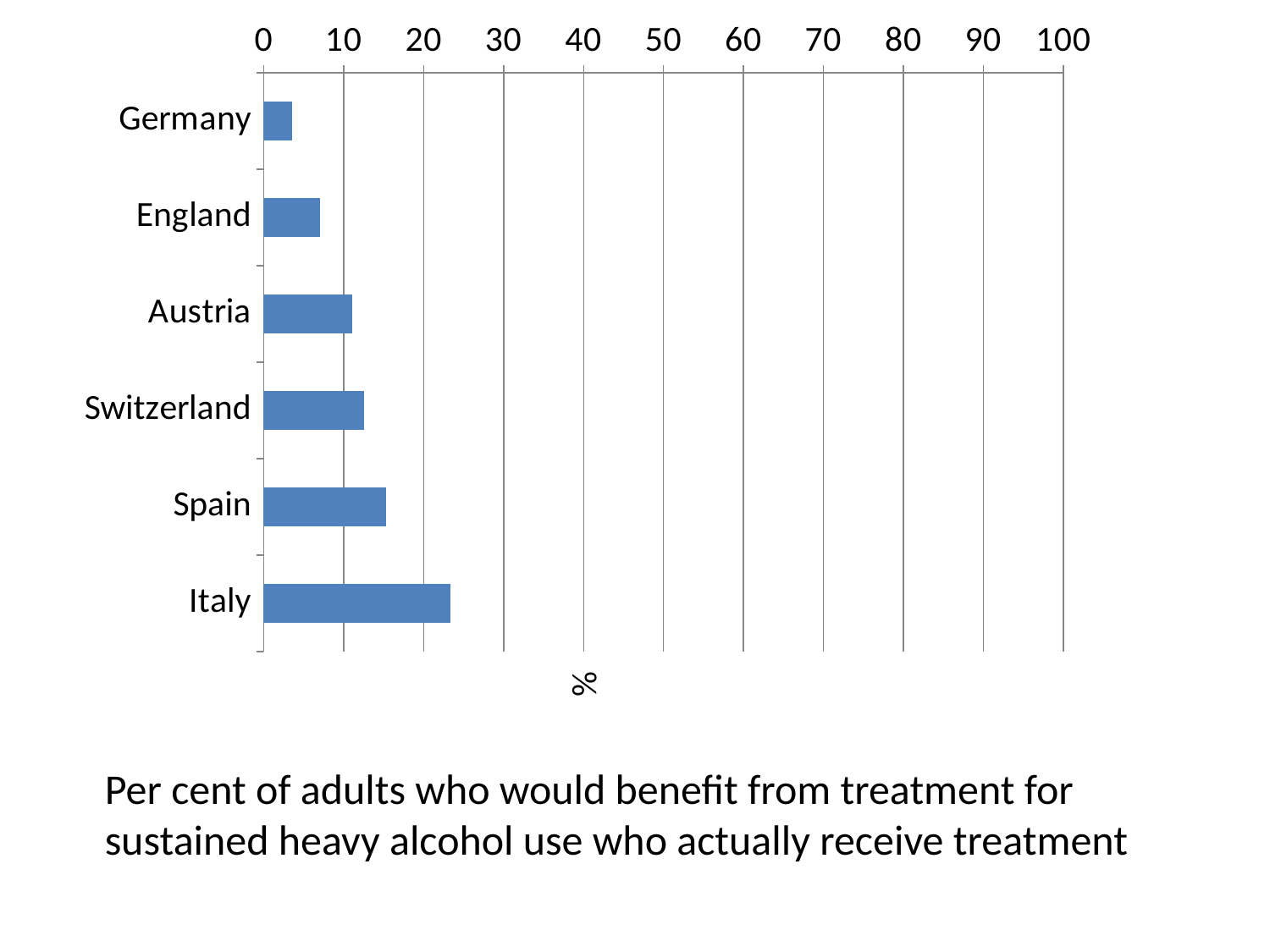
Is the value for Italy greater or less than 30? less Is the value for Italy greater or less than 20? greater Which has the larger value, Italy or Spain? Italy Is the value for Germany greater or less than 10? less Which country has the lowest value in the chart? Germany Which has the larger value, England or Germany? England How many countries are shown in the chart? 6 What is the label on the horizontal axis of the chart? % What kind of chart is shown on the slide? bar chart Which country has the highest value in the chart? Italy